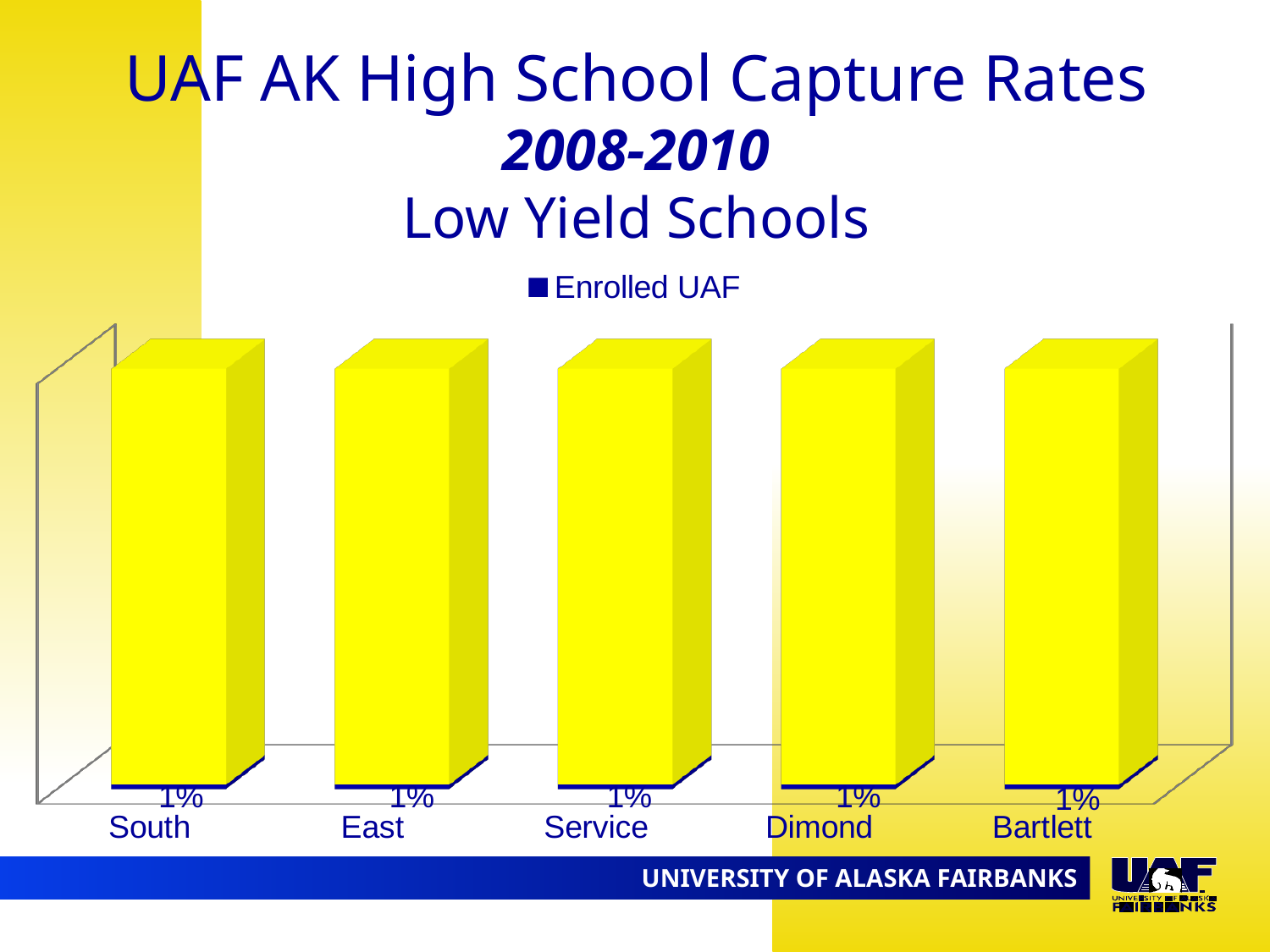
What colour are the bars in the chart? Yellow How many schools are shown on the chart? 5 What is the value for Dimond? 1% What series name is shown in the legend? Enrolled UAF What is the difference between the values for South and Bartlett? 0% What is the value for Service? 1% What kind of chart is shown on the slide? Bar chart How many series does the legend list? 1 What is the value for South? 1% What is the value for East? 1% Do the values rise, fall, or stay the same from South to Bartlett? Stay the same What is the value for Bartlett? 1%